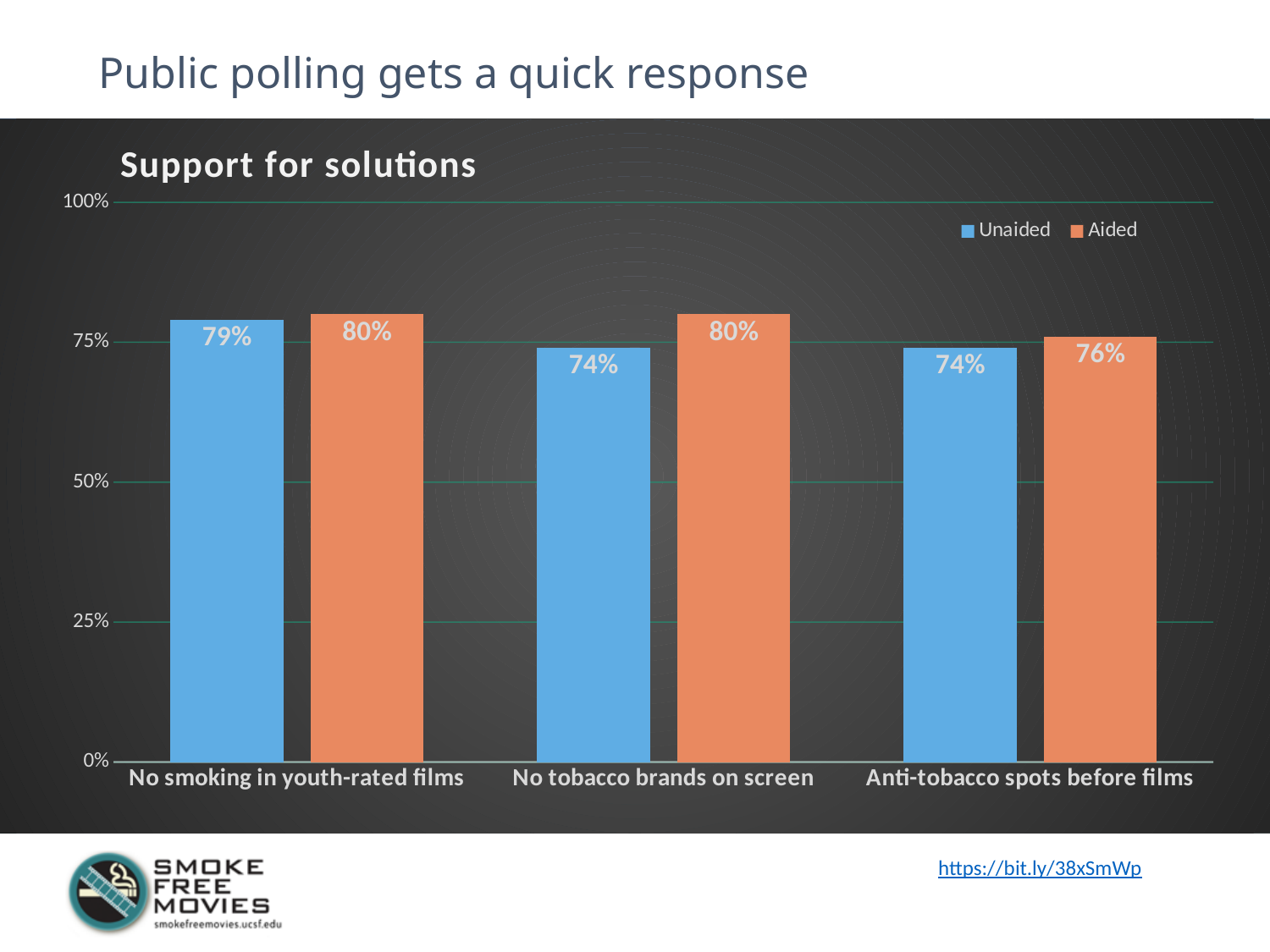
What is the Unaided value for No smoking in youth-rated films? 79% What is the difference between the Aided and Unaided values for No tobacco brands on screen? 6% Is the Unaided value for No tobacco brands on screen greater or less than 50%? greater What type of chart is shown? Bar chart What is the Aided value for Anti-tobacco spots before films? 76% What is the Aided value for No tobacco brands on screen? 80% Which category has the highest Unaided value? No smoking in youth-rated films Which is larger for No smoking in youth-rated films, the Unaided or the Aided value? Aided How many series does the legend list? 2 Which category has the lowest Aided value? Anti-tobacco spots before films How many categories are shown on the x axis? 3 What is the Unaided value for Anti-tobacco spots before films? 74%